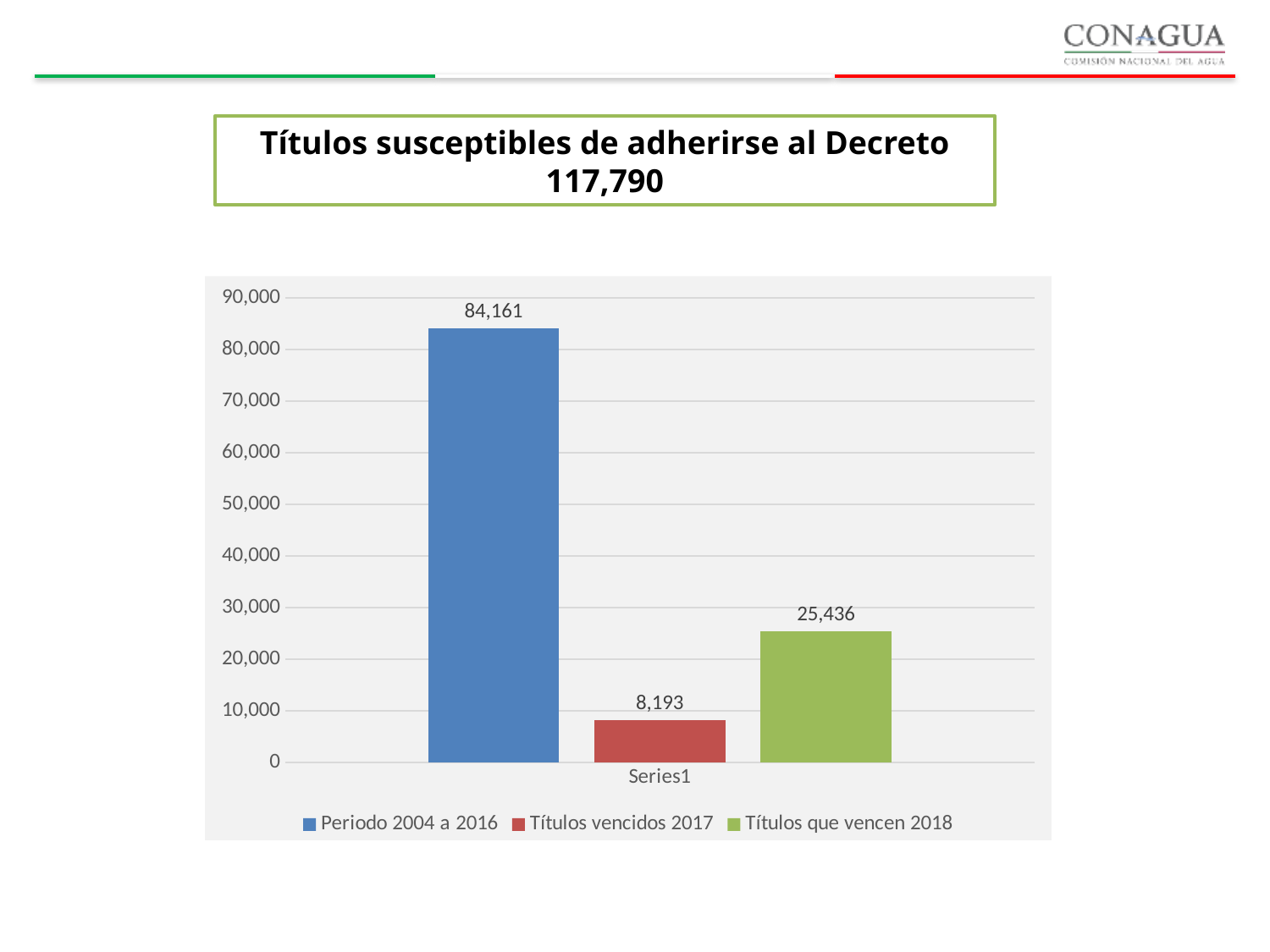
How many series does the legend list? 3 Which series has the highest value? Periodo 2004 a 2016 Which is larger, Títulos vencidos 2017 or Títulos que vencen 2018? Títulos que vencen 2018 What is the difference between Periodo 2004 a 2016 and Títulos que vencen 2018? 58,725 What colour is the bar for Títulos vencidos 2017? red What is the value for Periodo 2004 a 2016? 84,161 What kind of chart is shown on the slide? bar chart Is the value for Títulos que vencen 2018 greater or less than 30,000? less What is the value for Títulos que vencen 2018? 25,436 What is the difference between Títulos que vencen 2018 and Títulos vencidos 2017? 17,243 Which series has the lowest value? Títulos vencidos 2017 What is the value for Títulos vencidos 2017? 8,193